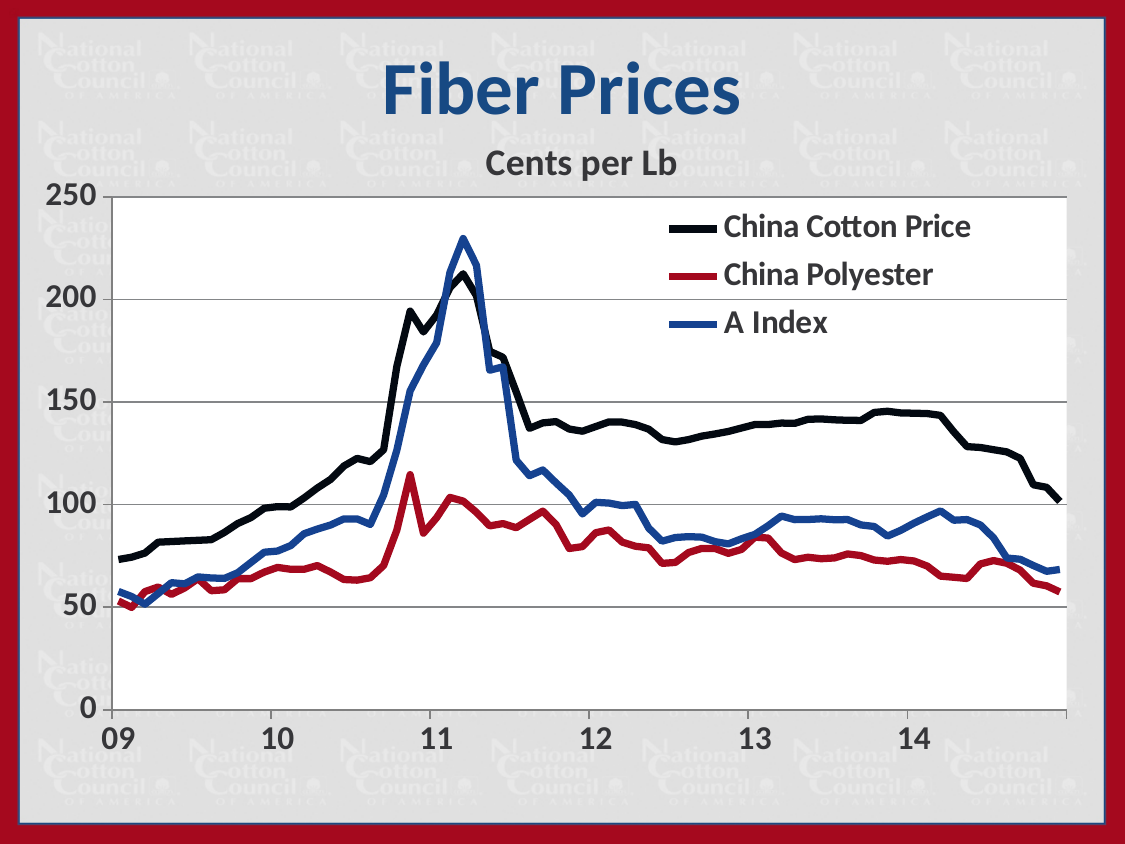
What unit is given for the values on the chart? Cents per Lb Is the A Index at the 14 tick greater or less than 100? less How many series does the legend list? 3 Is the peak value of the A Index greater or less than 200? greater What kind of chart is shown on the slide? Line chart Is the China Cotton Price at the 13 tick greater or less than 150? less Which series is drawn in blue? A Index At the 13 tick, which is higher: China Cotton Price or China Polyester? China Cotton Price Which series is lowest at the right-hand end of the chart? China Polyester Does the China Cotton Price rise or fall from the 14 tick to the end of the chart? Fall Which series reaches the highest peak on the chart? A Index